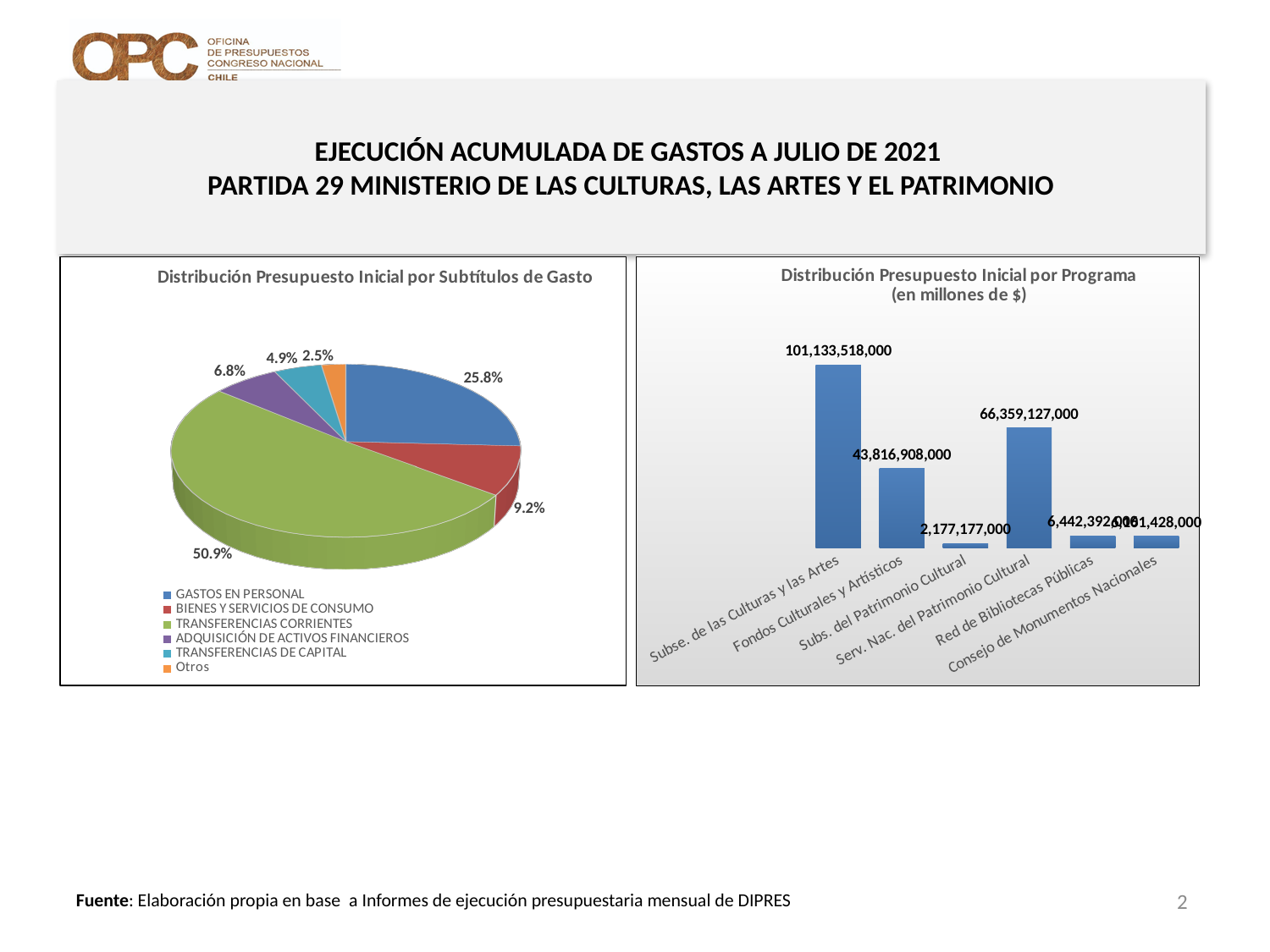
In the pie chart on the left, how many categories does the legend list? 6 In the bar chart on the right, what is the value for Subse. de las Culturas y las Artes? 101,133,518,000 What kind of chart is the 'Distribución Presupuesto Inicial por Programa' chart on the right? Bar chart In the pie chart on the left, which category has the largest slice? TRANSFERENCIAS CORRIENTES In the pie chart on the left, what is the difference in percentage points between GASTOS EN PERSONAL and BIENES Y SERVICIOS DE CONSUMO? 16.6 percentage points In the pie chart on the left, which category has the smallest slice? Otros In the bar chart on the right, which is larger: Fondos Culturales y Artísticos or Serv. Nac. del Patrimonio Cultural? Serv. Nac. del Patrimonio Cultural In the pie chart on the left, what share does TRANSFERENCIAS CORRIENTES have? 50.9% What kind of chart is the 'Distribución Presupuesto Inicial por Subtítulos de Gasto' chart on the left? Pie chart In the bar chart on the right, what is the difference between Subse. de las Culturas y las Artes and Serv. Nac. del Patrimonio Cultural? 34,774,391,000 In the bar chart on the right, which program has the lowest value? Subs. del Patrimonio Cultural In the pie chart on the left, what share does GASTOS EN PERSONAL have? 25.8%